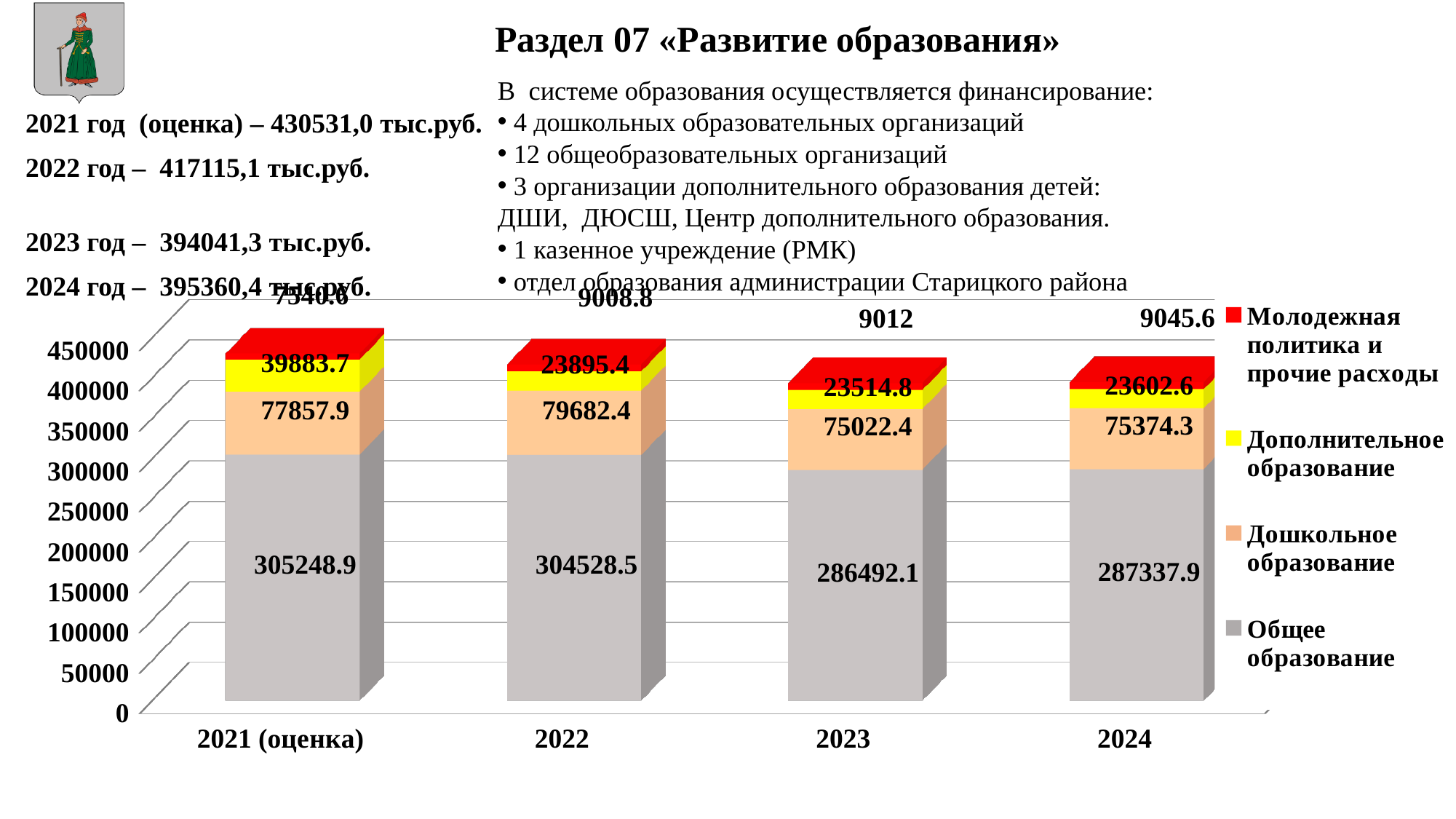
How many years (categories) are shown on the x axis of the chart? 4 What is the value of Молодежная политика и прочие расходы for 2024? 9045.6 In which year is the value of Общее образование the highest? 2021 (оценка) How many series does the chart legend list? 4 What is the value of Дошкольное образование for 2023? 75022.4 In which year is the value of Дошкольное образование the lowest? 2023 What is the total of the stacked bar for 2022? 417115.1 What kind of chart is shown on the slide? Stacked bar chart What is the value of Дополнительное образование for 2021 (оценка)? 39883.7 What is the value of Общее образование for 2022? 304528.5 By how much does Дополнительное образование in 2021 (оценка) exceed Дополнительное образование in 2022? 15988.3 Which year has the larger value for Молодежная политика и прочие расходы, 2023 or 2024? 2024